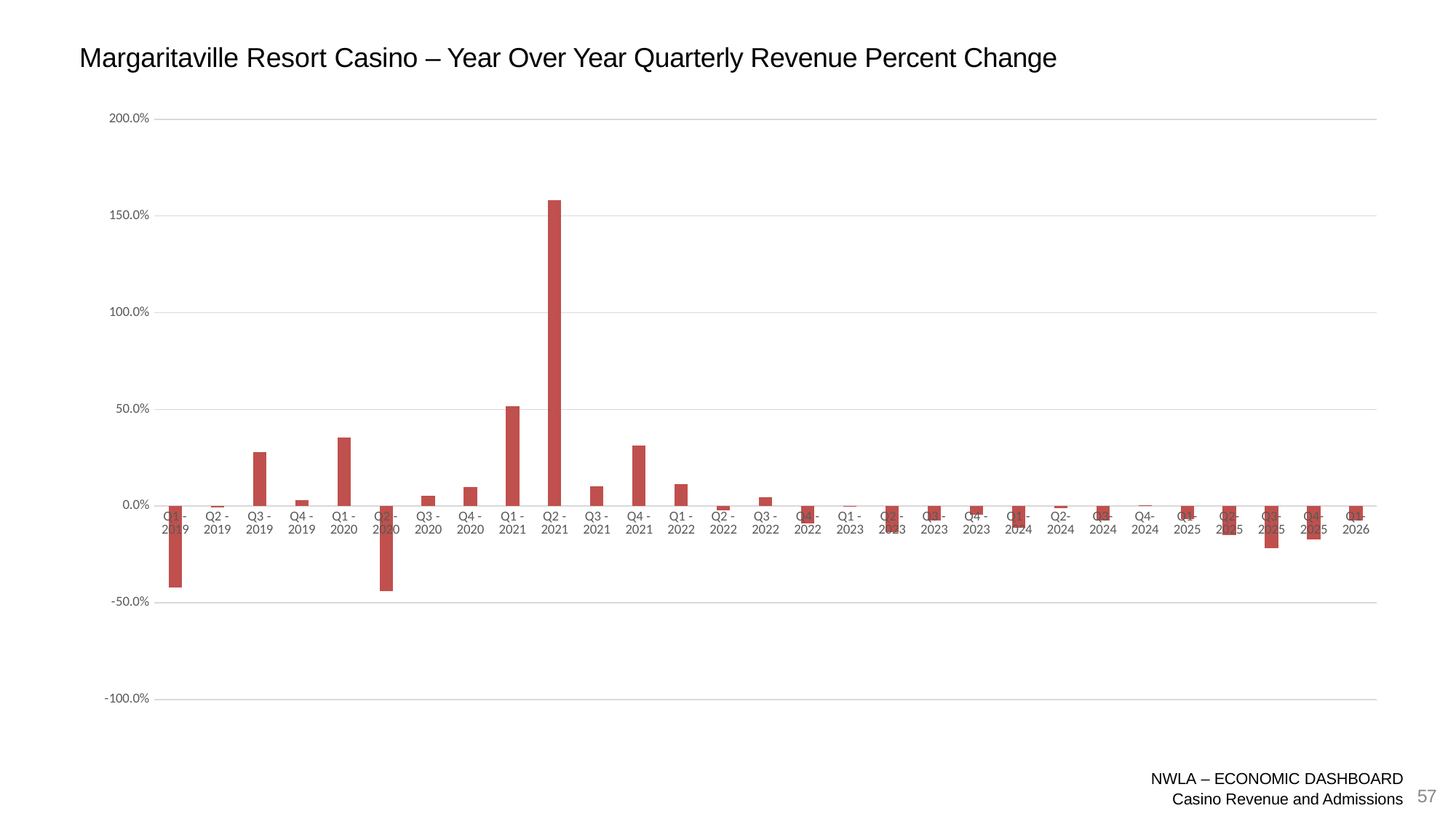
Is the value for Q2 - 2020 greater or less than -50.0%? greater Is the value for Q2 - 2021 greater or less than 150.0%? greater How many quarters are plotted on the x axis? 29 Do the values rise or fall from Q2 - 2021 to Q2 - 2022? Fall Is the value for Q1 - 2020 greater or less than 50.0%? less What type of chart is shown on the slide? Bar chart Which is larger, the value for Q3 - 2019 or the value for Q1 - 2020? Q1 - 2020 What is the title of the chart? Margaritaville Resort Casino – Year Over Year Quarterly Revenue Percent Change Which is larger, the value for Q4 - 2021 or the value for Q1 - 2022? Q4 - 2021 Which quarter has the highest year-over-year revenue percent change? Q2 - 2021